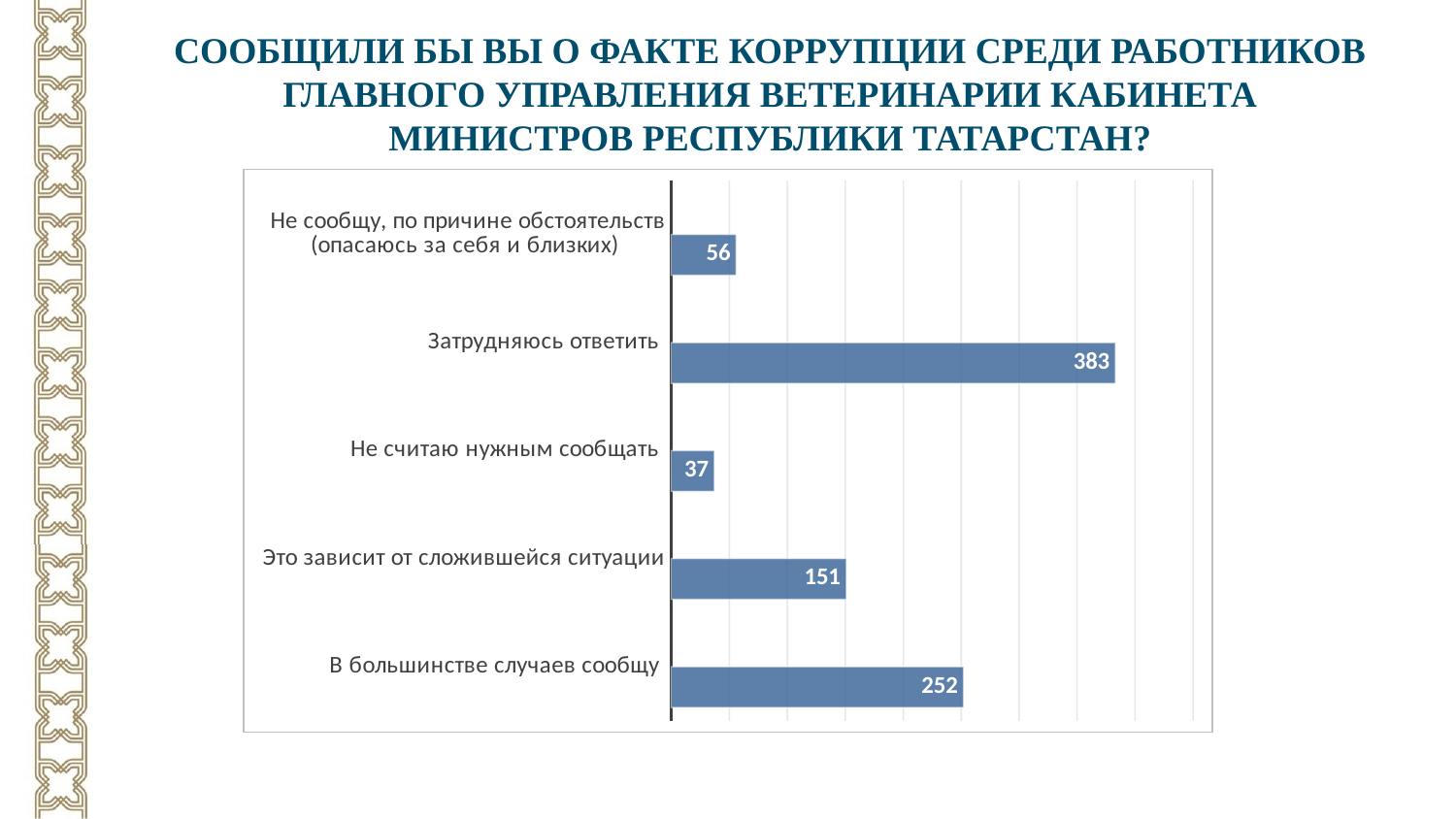
Which is larger: the value for «Не сообщу, по причине обстоятельств (опасаюсь за себя и близких)» or for «Не считаю нужным сообщать»? Не сообщу, по причине обстоятельств (опасаюсь за себя и близких) What is the value for «Затрудняюсь ответить»? 383 What is the difference between the values for «В большинстве случаев сообщу» and «Это зависит от сложившейся ситуации»? 101 Which category has the highest value? Затрудняюсь ответить What kind of chart is shown on the slide? Bar chart What is the value for «В большинстве случаев сообщу»? 252 What is the value for «Не считаю нужным сообщать»? 37 What is the difference between the values for «Затрудняюсь ответить» and «В большинстве случаев сообщу»? 131 What is the value for «Это зависит от сложившейся ситуации»? 151 How many categories are shown in the chart? 5 What is the value for «Не сообщу, по причине обстоятельств (опасаюсь за себя и близких)»? 56 Which category has the lowest value? Не считаю нужным сообщать